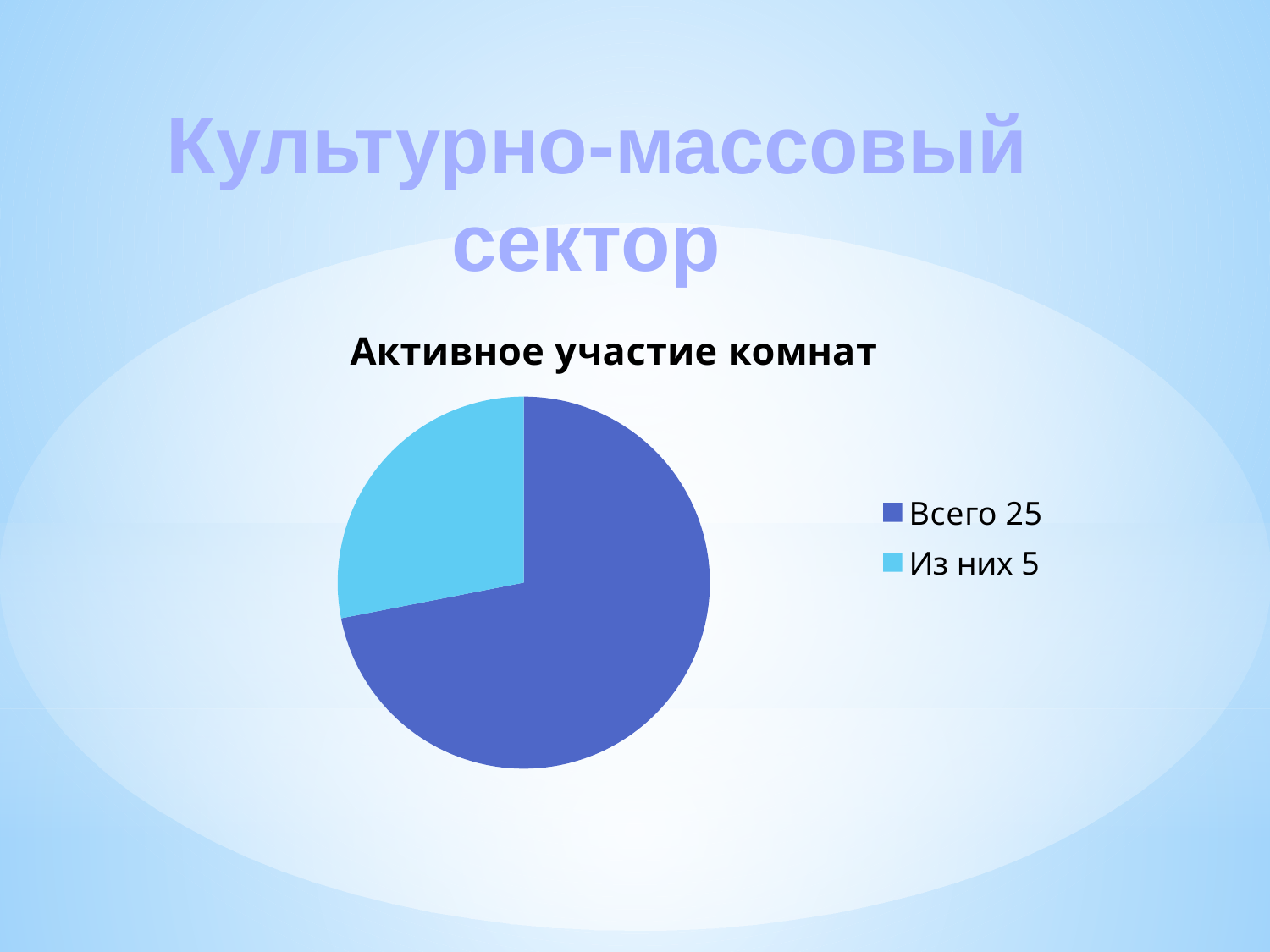
What colour is the "Из них 5" slice? light blue Which slice is larger, "Всего 25" or "Из них 5"? Всего 25 Which slice of the pie chart is the largest? Всего 25 Which slice of the pie chart is the smallest? Из них 5 How many entries does the legend list? 2 What kind of chart is shown on the slide? pie chart What is the title of the chart? Активное участие комнат How many slices does the pie chart have? 2